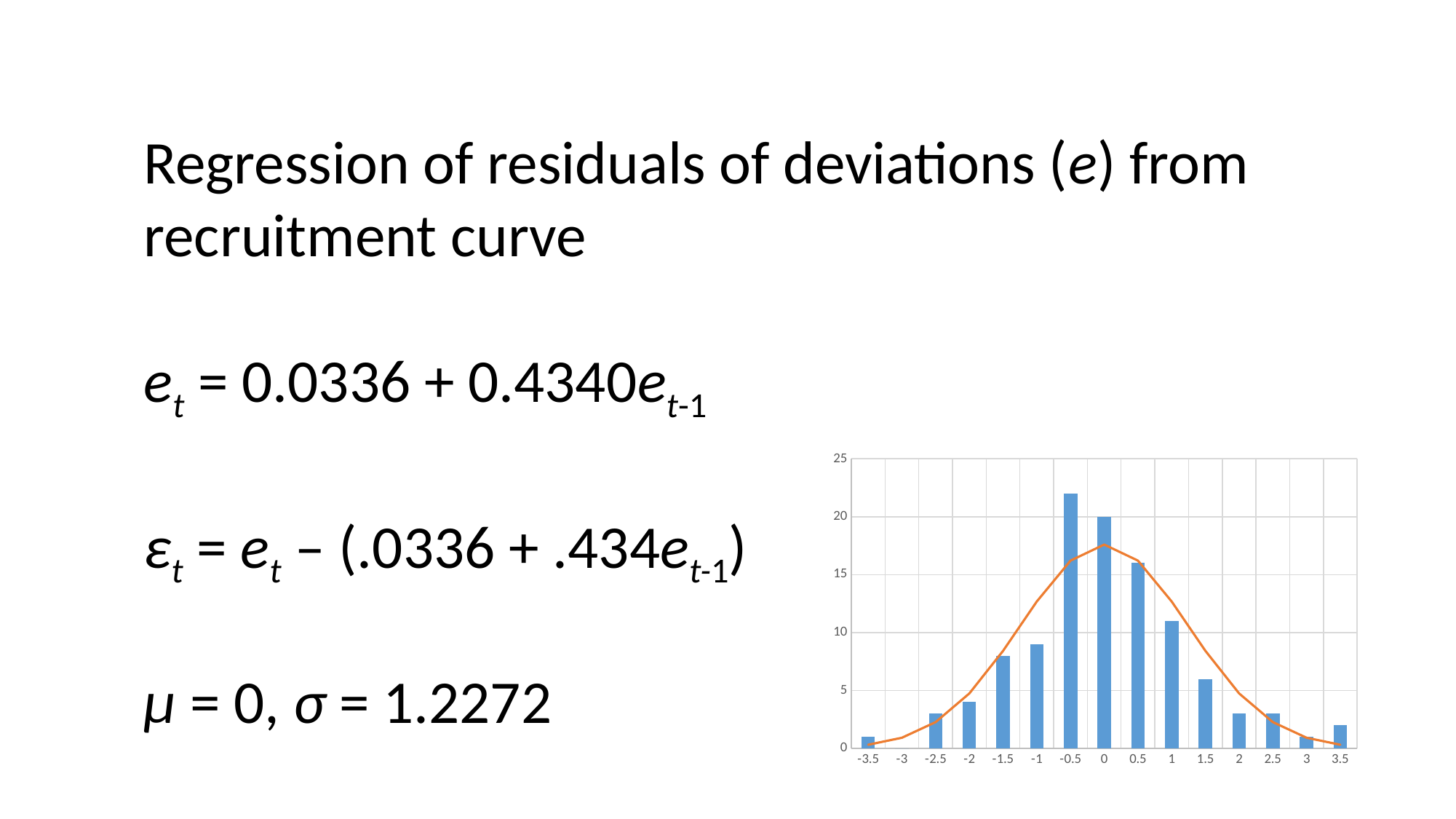
Is the bar for -0.5 greater or less than 20? greater Which x-axis category has the tallest bar? -0.5 Is the bar for 1 greater or less than 10? greater Is the bar for -1 greater or less than 10? less What colour is the curve drawn over the bars? Orange Which bar is taller, the one at 1 or the one at 1.5? 1 Which bar is taller, the one at -0.5 or the one at 0? -0.5 Do the bar heights rise or fall as the x axis goes from 0 to 3? fall What kind of chart is shown on the slide? Bar chart with a line overlay How many categories are shown on the x axis of the chart? 15